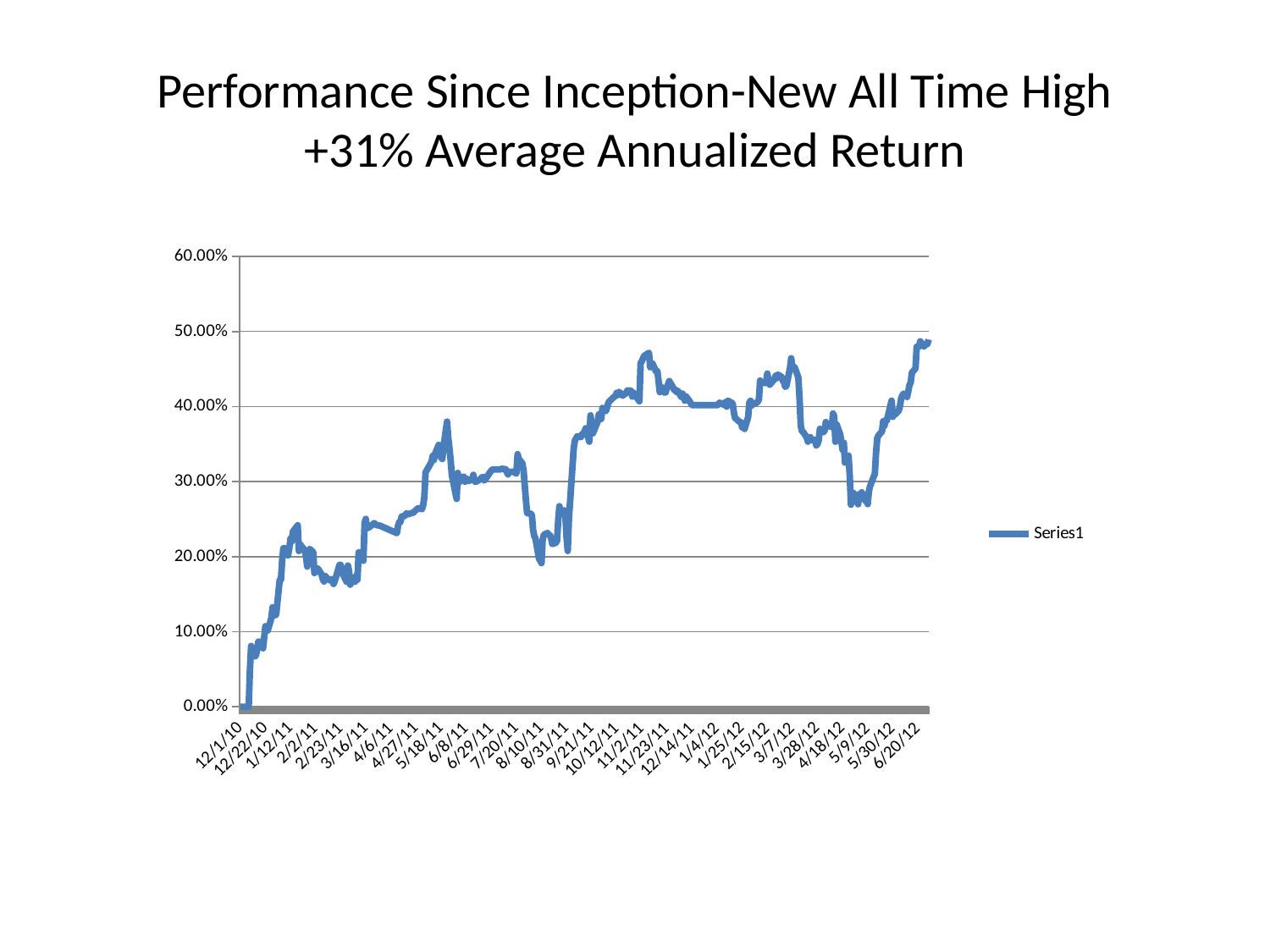
Is the value for 6/20/12 greater or less than 40%? greater Overall, do the values rise or fall from 12/1/10 to 6/20/12? rise Is the value for 5/9/12 greater or less than 30%? less What is the name of the series shown in the legend? Series1 What kind of chart is shown on the slide? line chart Is the value for 11/2/11 greater or less than 40%? greater What is the value of Series1 at the first date, 12/1/10? 0.00% Which is larger, the value at 12/22/10 or the value at 6/20/12? 6/20/12 How many series does the legend list? 1 What is the highest value shown on the vertical axis? 60.00%